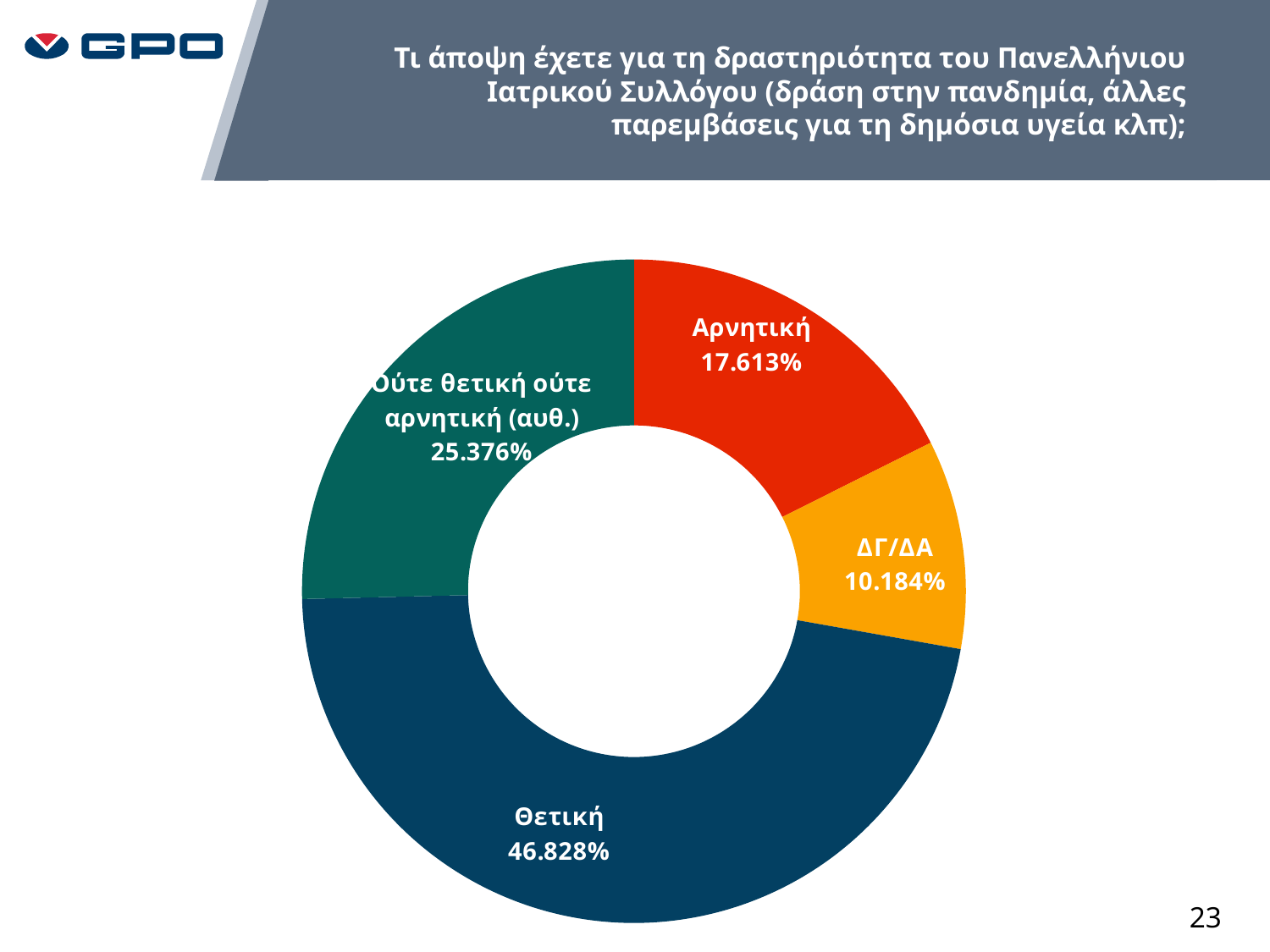
Which category has the smallest slice of the chart? ΔΓ/ΔΑ What is the difference between the Αρνητική and ΔΓ/ΔΑ shares? 7.429% What percentage of respondents answered Θετική? 46.828% What type of chart is shown on the slide? Donut (pie) chart What percentage is shown for Ούτε θετική ούτε αρνητική (αυθ.)? 25.376% What colour is the Θετική slice? Dark blue What is the difference in percentage points between Θετική and Ούτε θετική ούτε αρνητική (αυθ.)? 21.452% Which is larger, the Αρνητική slice or the Ούτε θετική ούτε αρνητική (αυθ.) slice? Ούτε θετική ούτε αρνητική (αυθ.) What share is shown for ΔΓ/ΔΑ? 10.184% Which category has the largest slice of the chart? Θετική What is the value shown for the Αρνητική slice? 17.613% How many categories are shown in the chart? 4